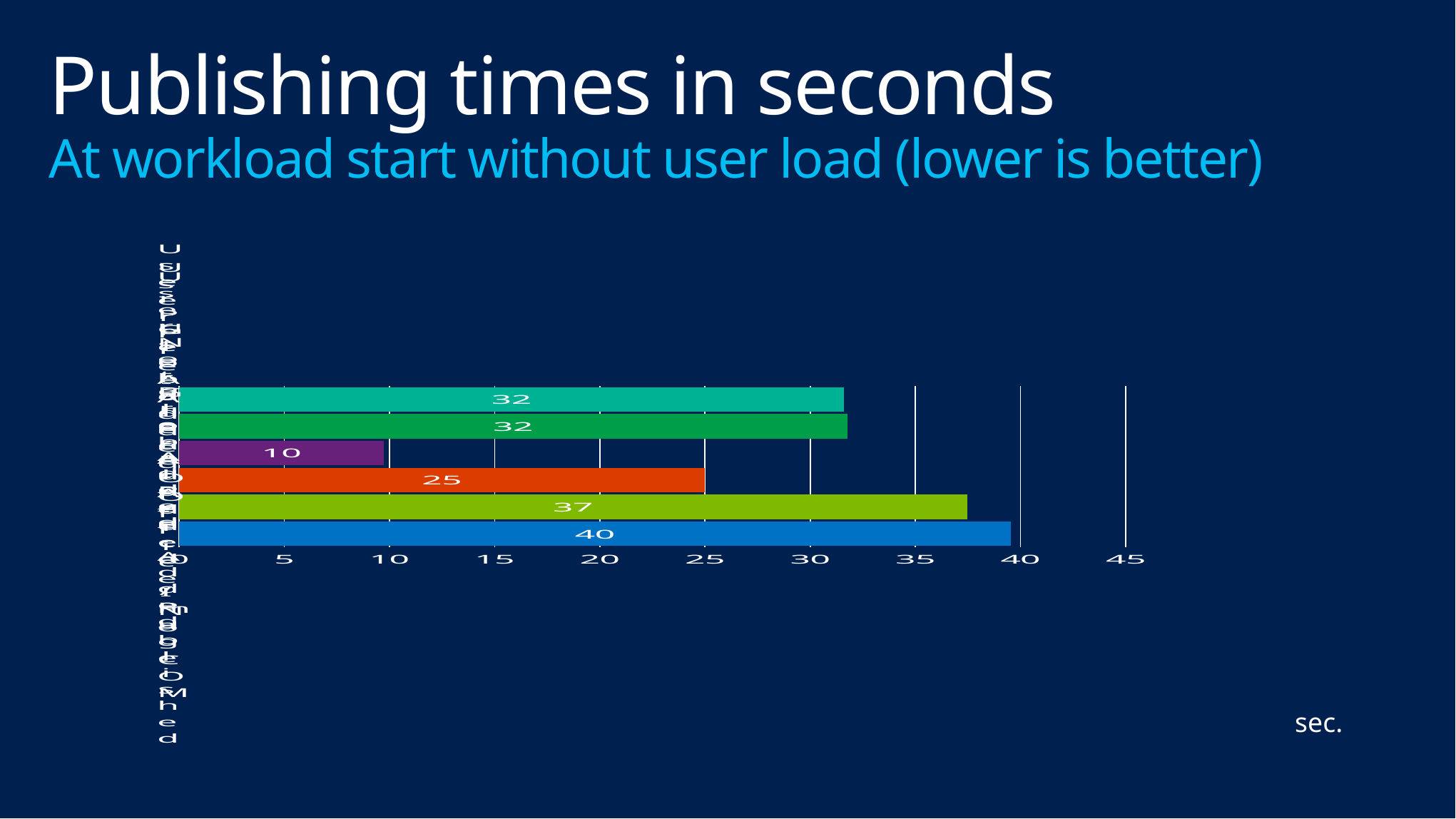
What is the title of the slide containing the chart? Publishing times in seconds What is the lowest value shown in the chart? 10 What kind of chart is shown on the slide? bar chart What is the difference between the largest bar value (40) and the smallest bar value (10)? 30 What is the value shown on the orange-red bar? 25 Is the value of the purple bar greater or less than 15? less What is the value shown on the light green bar? 37 How many bars are plotted in the chart? 6 What is the value shown on the purple bar? 10 What is the highest value shown in the chart? 40 Which is larger, the value of the light green bar or the value of the orange-red bar? the light green bar What is the value shown on the blue bar at the bottom of the chart? 40